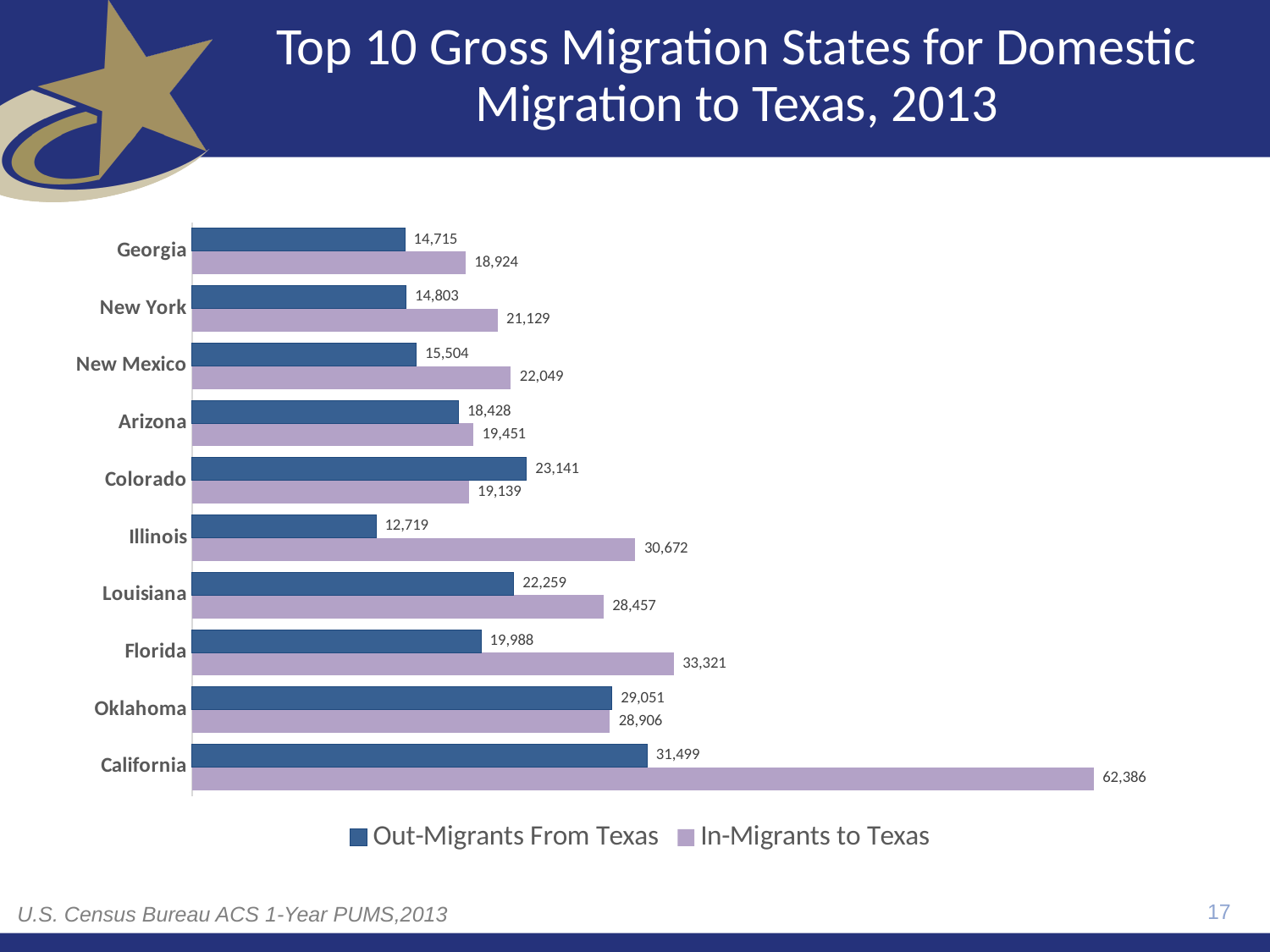
What is the difference between In-Migrants to Texas and Out-Migrants From Texas for California? 30,887 What is the total of Out-Migrants From Texas and In-Migrants to Texas for Oklahoma? 57,957 How many states are shown in the chart? 10 For Colorado, which is larger: Out-Migrants From Texas or In-Migrants to Texas? Out-Migrants From Texas How many series does the legend list? 2 What is the number of In-Migrants to Texas from California? 62,386 What is the number of In-Migrants to Texas from Florida? 33,321 What kind of chart is shown on the slide? Bar chart Which state has the lowest number of Out-Migrants From Texas? Illinois Which state has the highest number of In-Migrants to Texas? California What is the title of the chart? Top 10 Gross Migration States for Domestic Migration to Texas, 2013 What is the number of Out-Migrants From Texas to Illinois? 12,719